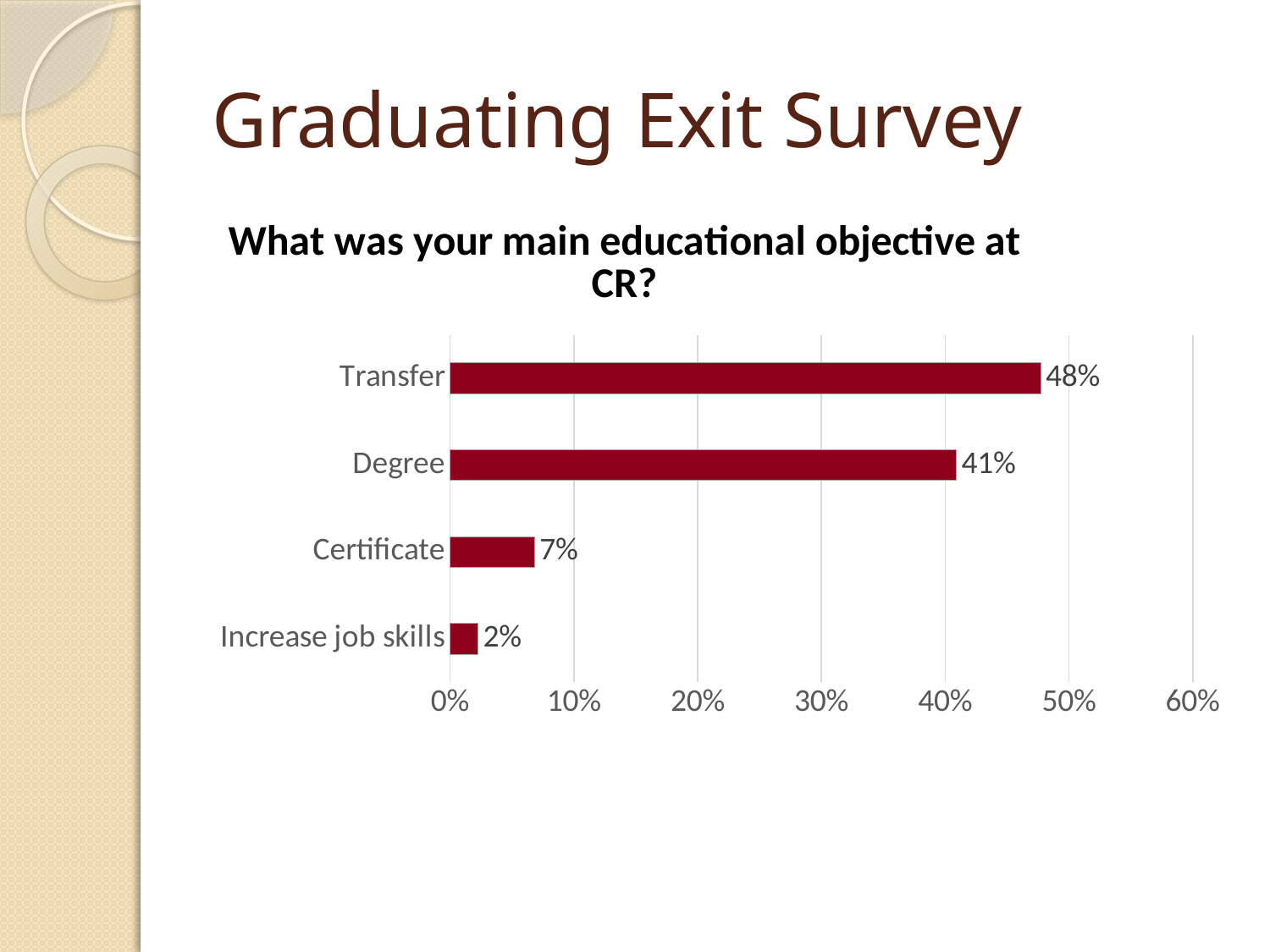
What percentage of respondents chose Transfer as their main educational objective? 48% What is the value shown for Degree? 41% What is the value shown for Certificate? 7% What is the difference in percentage points between Transfer and Degree? 7 What is the title of the chart? What was your main educational objective at CR? What is the value shown for Increase job skills? 2% Which educational objective has the highest percentage? Transfer Which educational objective has the lowest percentage? Increase job skills Is the value for Degree greater or less than 30%? greater How many categories are shown in the chart? 4 What kind of chart is shown on the slide? Bar chart Which is larger, the value for Certificate or the value for Increase job skills? Certificate